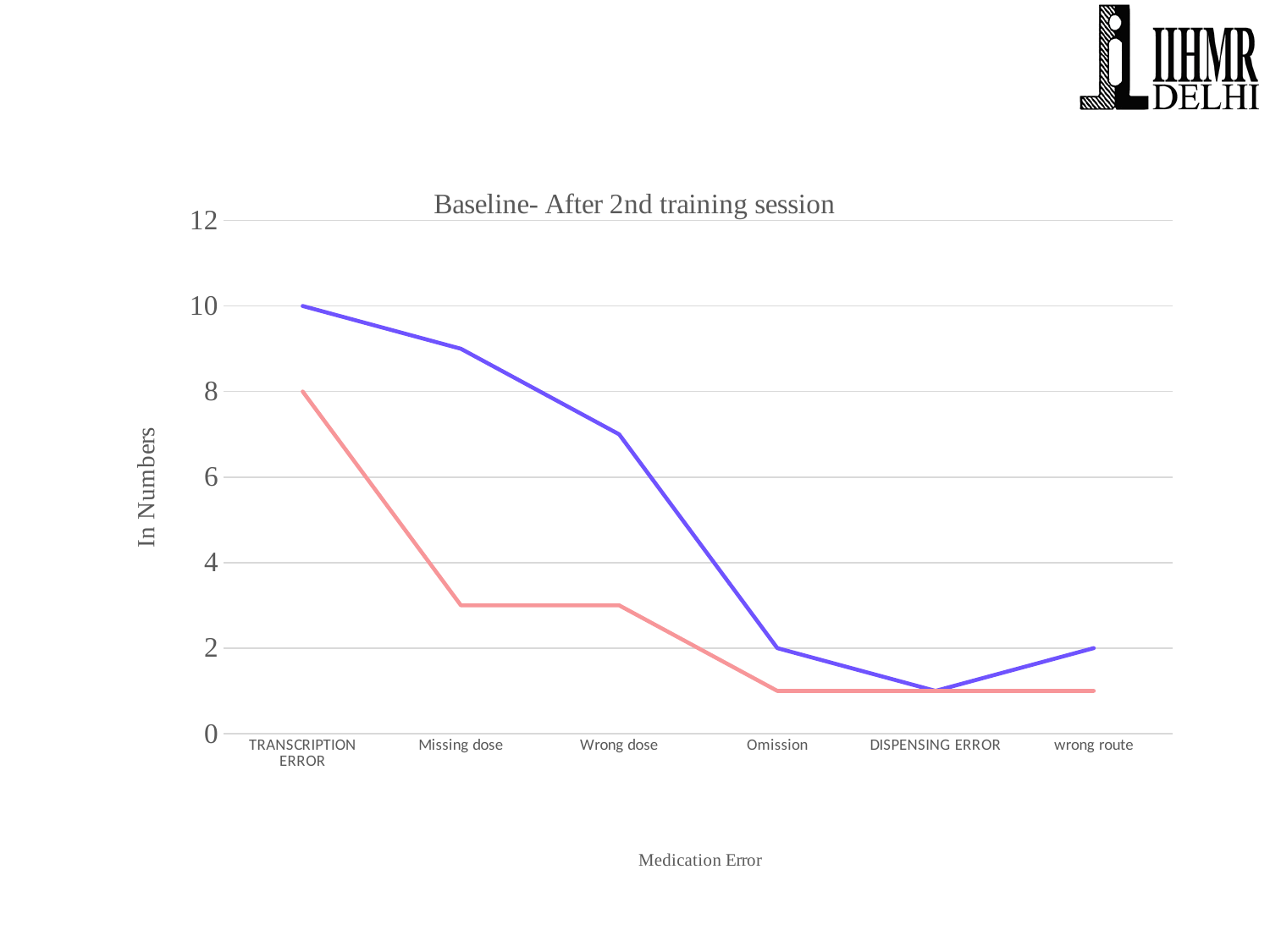
Is the value of the blue line for Wrong dose greater or less than 6? greater What is the value of the blue line for wrong route? 2 What is the value of the pink line for TRANSCRIPTION ERROR? 8 How many medication error categories are shown on the x axis? 6 What kind of chart is shown on the slide? Line chart Is the value of the pink line for Missing dose greater or less than 4? less What is the title of the chart? Baseline- After 2nd training session For Missing dose, which line has the higher value, the blue line or the pink line? Blue line What is the difference between the blue line and the pink line for TRANSCRIPTION ERROR? 2 What is the value of the blue line for Omission? 2 At which category does the blue line reach its highest value? TRANSCRIPTION ERROR What is the value of the blue line for TRANSCRIPTION ERROR? 10